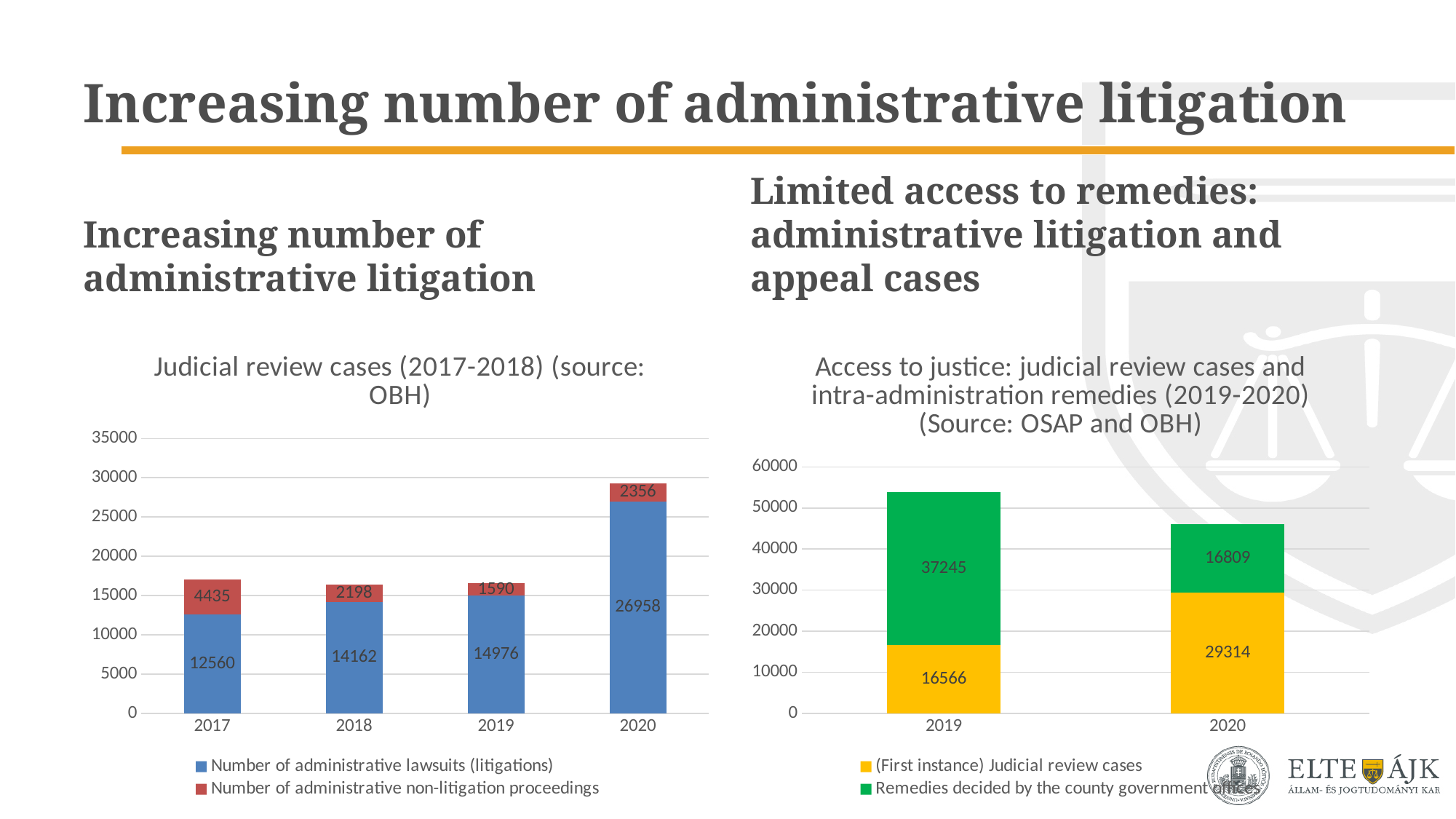
In the left chart (Judicial review cases), what is the number of administrative lawsuits (litigations) in 2020? 26958 In the left chart (Judicial review cases), which year has the highest number of administrative lawsuits (litigations)? 2020 In the right chart (Access to justice), what is the number of remedies decided by the county government offices in 2019? 37245 In the left chart (Judicial review cases), which year has the lowest number of administrative non-litigation proceedings? 2019 In the left chart (Judicial review cases), what is the difference between the number of administrative lawsuits in 2020 and in 2019? 11982 In the left chart (Judicial review cases), what is the total of the stacked bar for 2017? 16995 In the right chart (Access to justice), what is the number of (first instance) judicial review cases in 2020? 29314 What type of chart is the right chart (Access to justice)? Stacked bar chart In the right chart (Access to justice), what is the total of the stacked bar for 2020? 46123 In the left chart (Judicial review cases), how many years are shown on the x axis? 4 In the left chart (Judicial review cases), what is the number of administrative non-litigation proceedings in 2017? 4435 In the right chart (Access to justice), which is larger in 2019: judicial review cases or remedies decided by the county government offices? Remedies decided by the county government offices